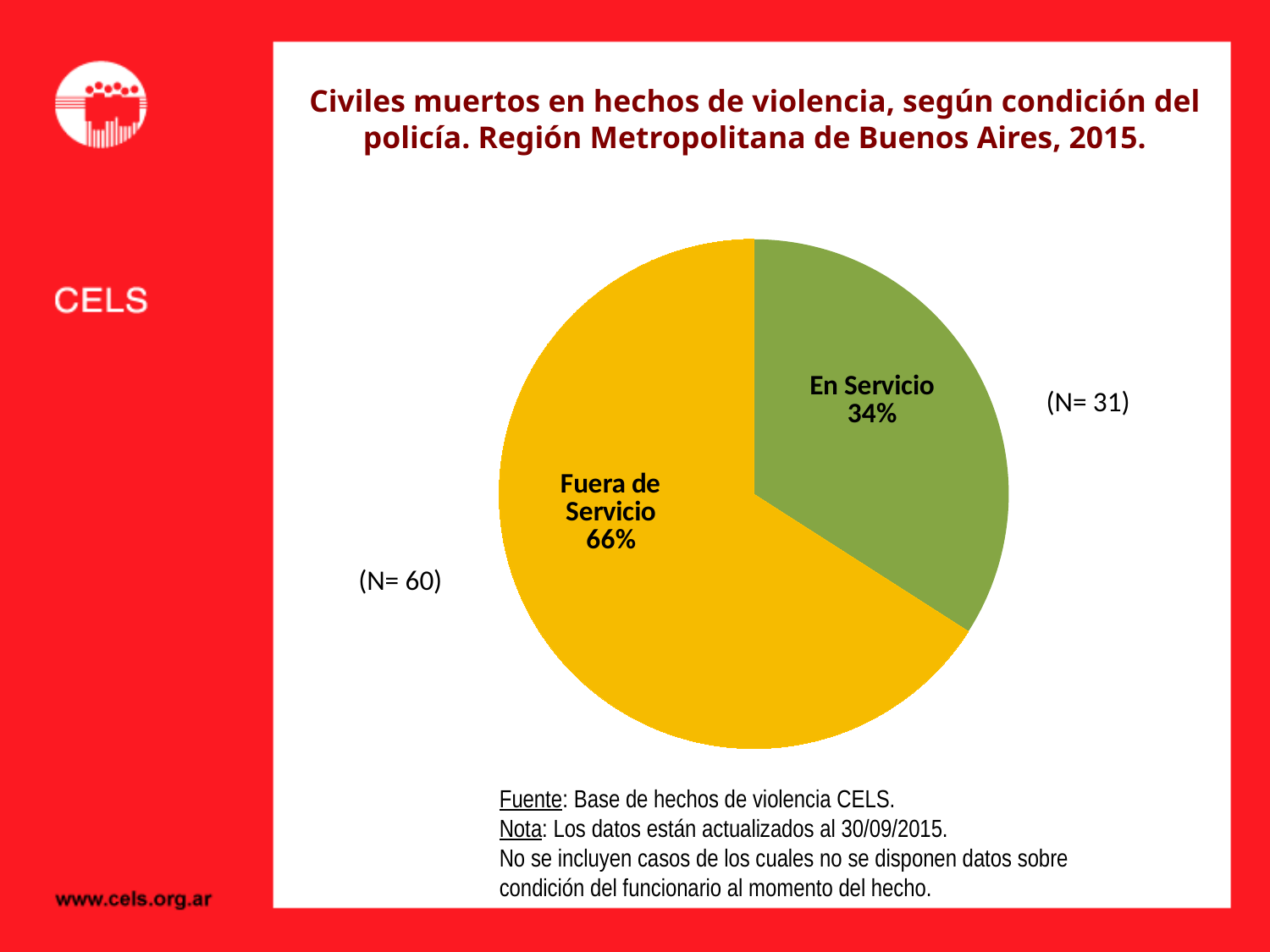
What kind of chart is shown on the slide? Pie chart What is the total N across both slices of the pie? 91 What colour is the "En Servicio" slice? Green What is the N value shown next to the "En Servicio" slice? 31 How many categories are shown in the pie chart? 2 Which category has the largest slice of the pie? Fuera de Servicio Which is larger, the N for "Fuera de Servicio" or the N for "En Servicio"? Fuera de Servicio What share of the pie does the "Fuera de Servicio" slice represent? 66% What is the difference in percentage points between the "Fuera de Servicio" and "En Servicio" slices? 32 Which category has the smallest slice of the pie? En Servicio What share of the pie does the "En Servicio" slice represent? 34% What is the N value shown next to the "Fuera de Servicio" slice? 60